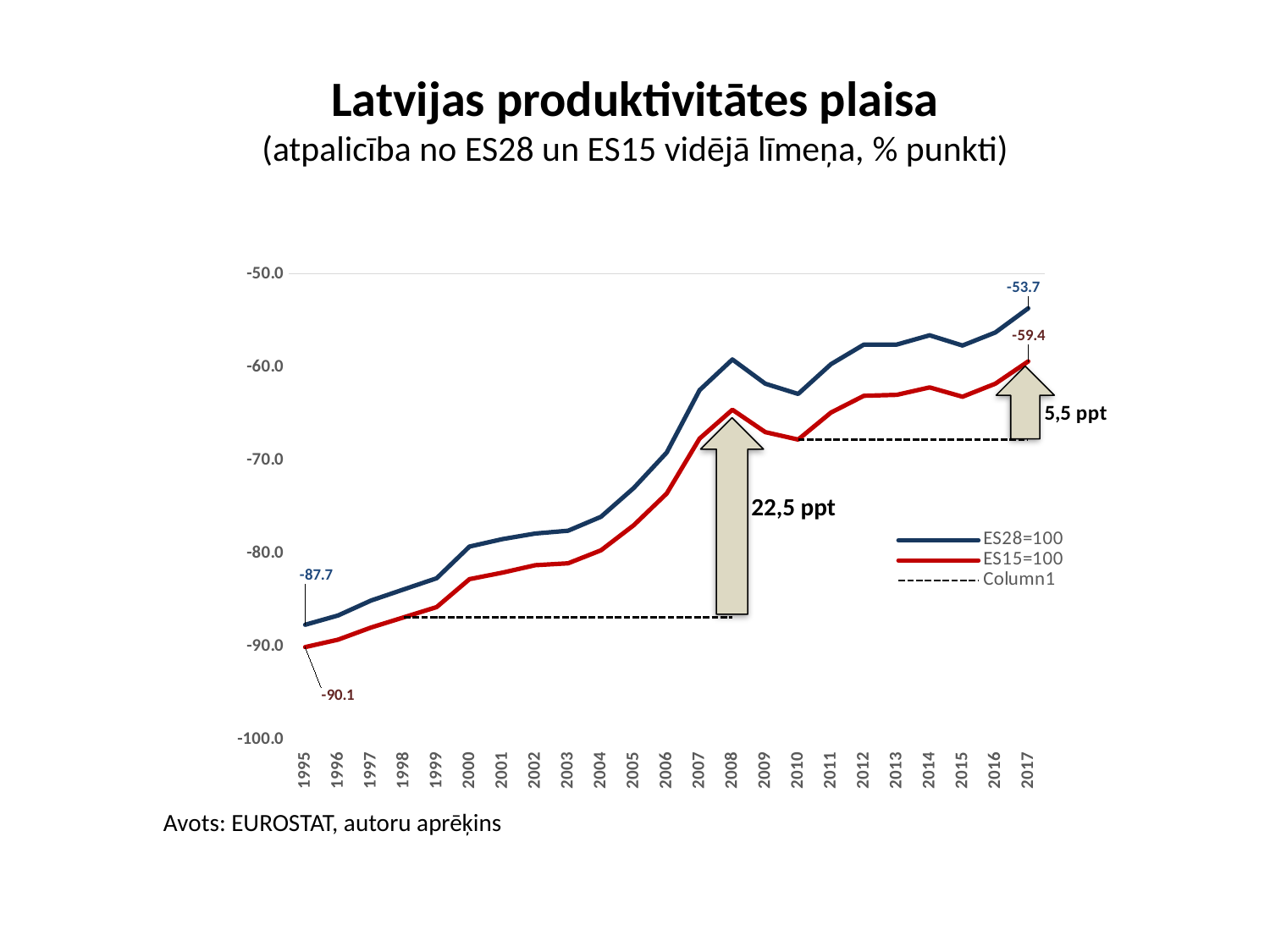
Is the value of the ES15=100 series in 2005 greater or less than -70.0? less Which series has the higher value in 2017, ES28=100 or ES15=100? ES28=100 What improvement in ppt is annotated by the large arrow at 2008? 22,5 ppt Do the plotted values generally rise or fall from 1995 to 2017? rise How many years are shown on the x axis of the chart? 23 What is the value of the ES15=100 series in 2017? -59.4 What is the value of the ES28=100 series in 1995? -87.7 What is the difference between the ES28=100 and ES15=100 values in 2017? 5.7 What is the value of the ES15=100 series in 1995? -90.1 What is the value of the ES28=100 series in 2017? -53.7 By how much did the ES28=100 value change between 1995 and 2017? 34.0 What kind of chart is shown on the slide? line chart